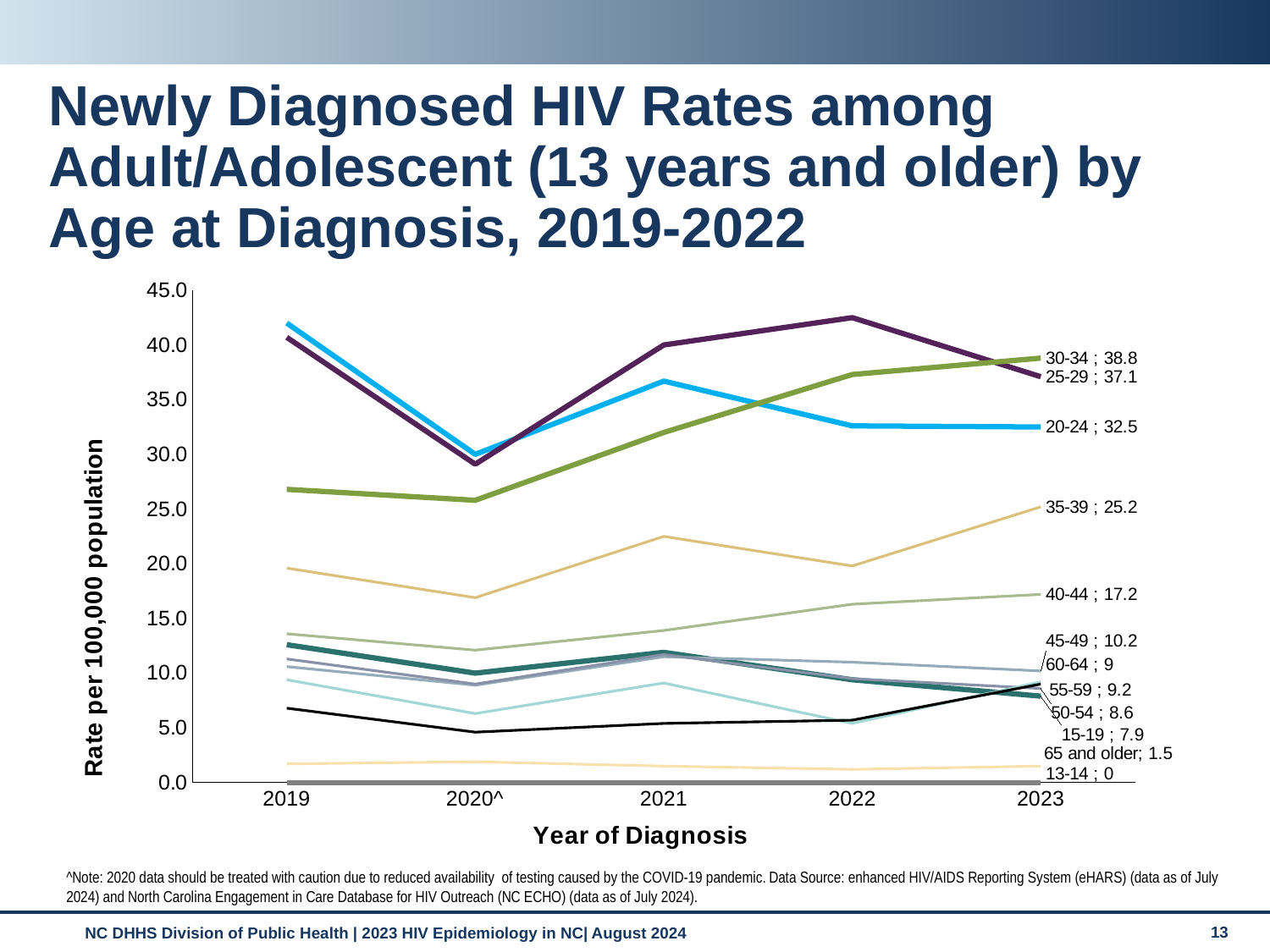
Which age group has the lowest rate in 2023? 13-14 In 2023, which age group has the higher rate: 35-39 or 40-44? 35-39 What kind of chart is shown on the slide? Line chart Is the value for the 35-39 age group in 2021 greater or less than 20.0? greater Which age group has the highest rate in 2023? 30-34 What is the 2023 rate for the 30-34 age group? 38.8 Does the rate for the 30-34 age group rise or fall from 2020 to 2023? Rise Is the value for the 20-24 age group in 2019 greater or less than 40.0? greater What is the difference between the 2023 rates for the 30-34 and 25-29 age groups? 1.7 What is the 2023 rate for the 20-24 age group? 32.5 How many years of diagnosis are shown on the x axis? 5 What is the 2023 rate for the 65 and older age group? 1.5